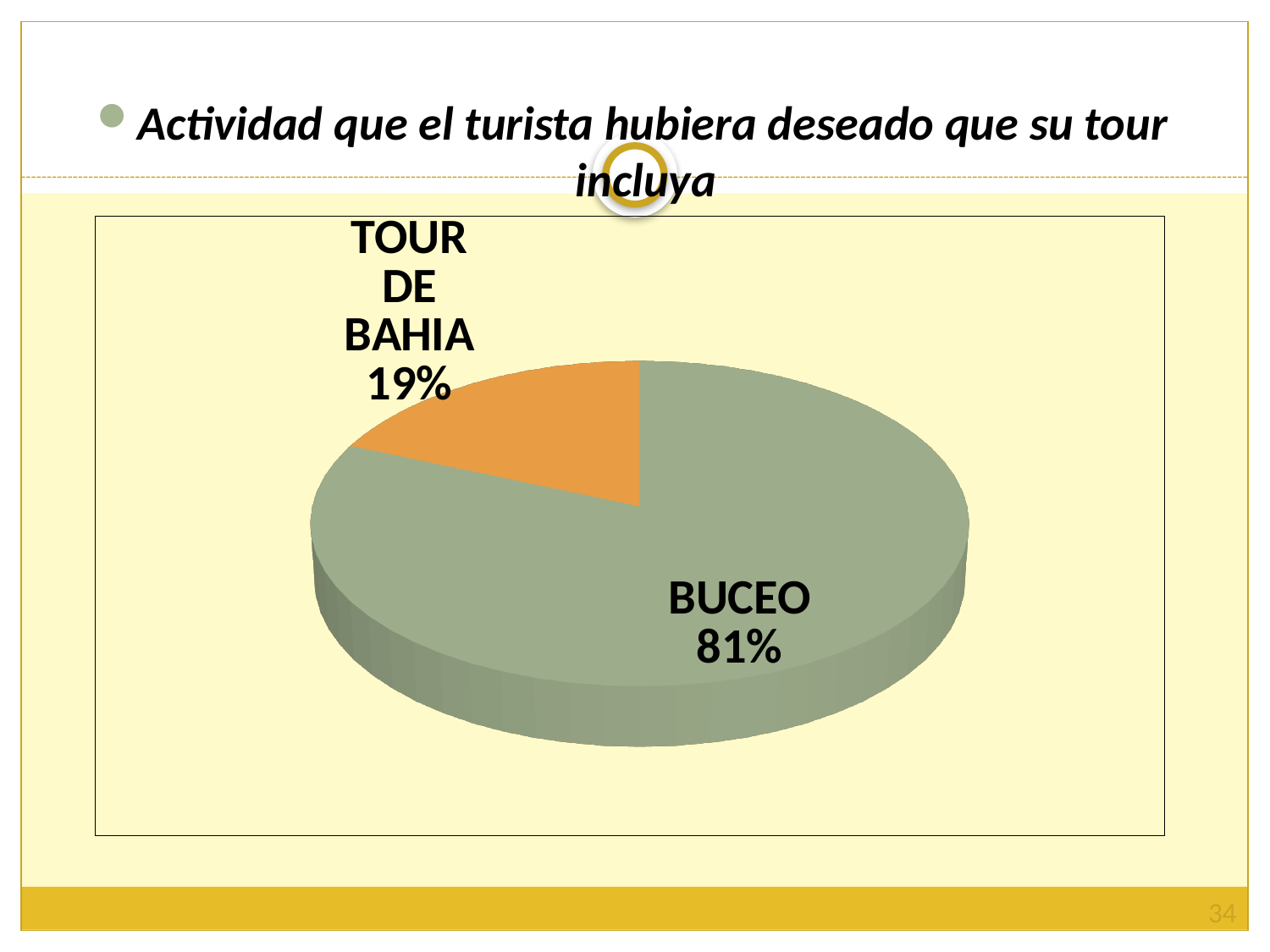
What kind of chart is shown on the slide? Pie chart What colour is the BUCEO slice? Green What colour is the TOUR DE BAHIA slice? Orange Which category has the smallest share of the pie? TOUR DE BAHIA How many categories are shown in the pie chart? 2 What share of the pie does BUCEO represent? 81% Which is larger, the share for BUCEO or the share for TOUR DE BAHIA? BUCEO What is the difference in percentage points between BUCEO and TOUR DE BAHIA? 62 What share of the pie does TOUR DE BAHIA represent? 19% Which category has the largest share of the pie? BUCEO